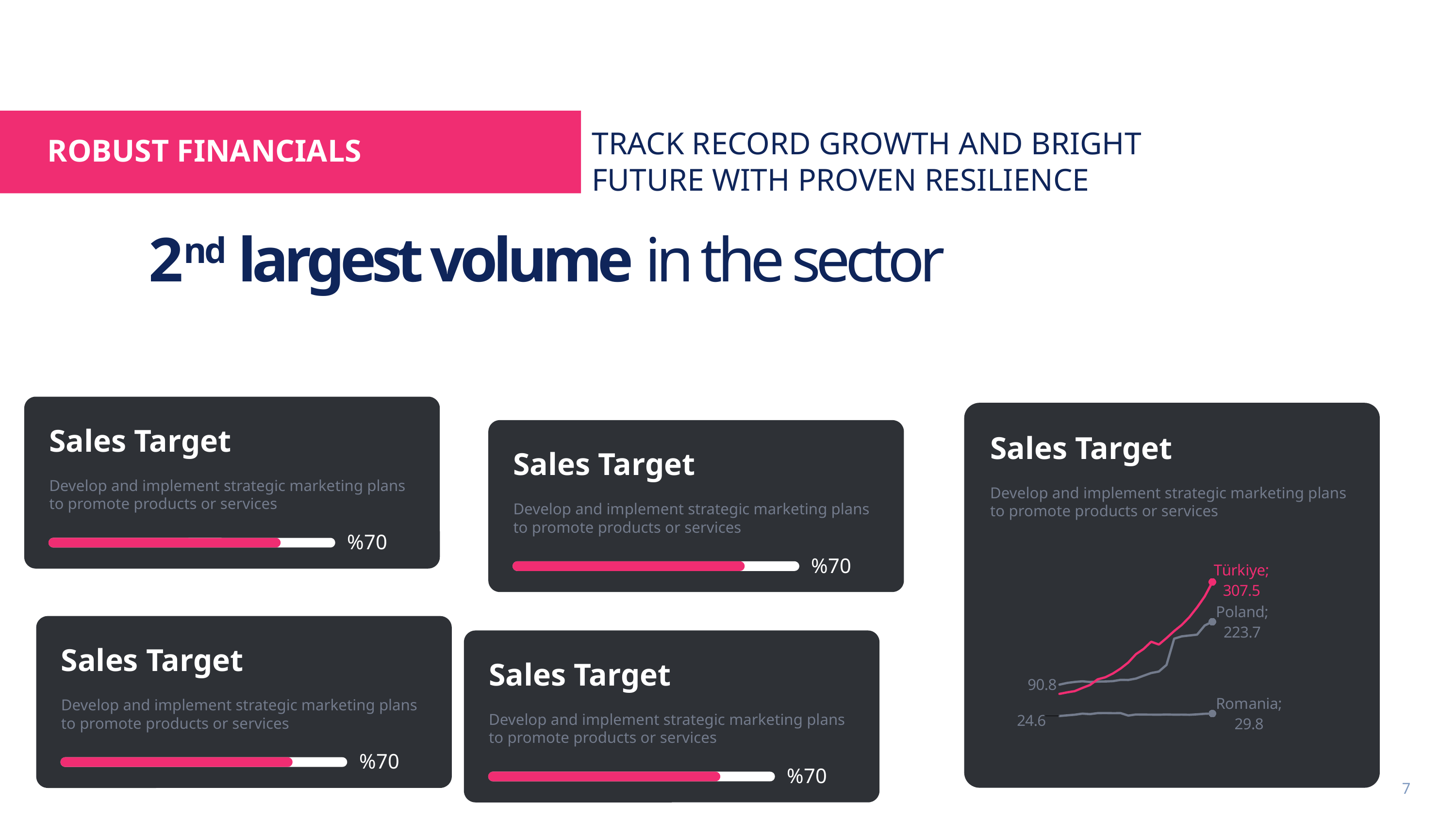
In the line chart on the right, what is the difference between the final values of Türkiye and Poland? 83.8 In the line chart on the right, what colour is the Türkiye line? Pink In the line chart on the right, which country has the lowest final value? Romania In the line chart on the right, does the Türkiye line rise or fall from left to right? Rises In the line chart on the right, which is larger at the end: Türkiye or Poland? Türkiye How many lines are plotted in the line chart on the right? 3 In the line chart on the right, what is the final value shown for Türkiye? 307.5 In the line chart on the right, what is the difference between the final values of Poland and Romania? 193.9 In the line chart on the right, which country has the highest final value? Türkiye In the line chart on the right, what is the final value shown for Romania? 29.8 What kind of chart is shown in the right-hand card? Line chart In the line chart on the right, what is the final value shown for Poland? 223.7